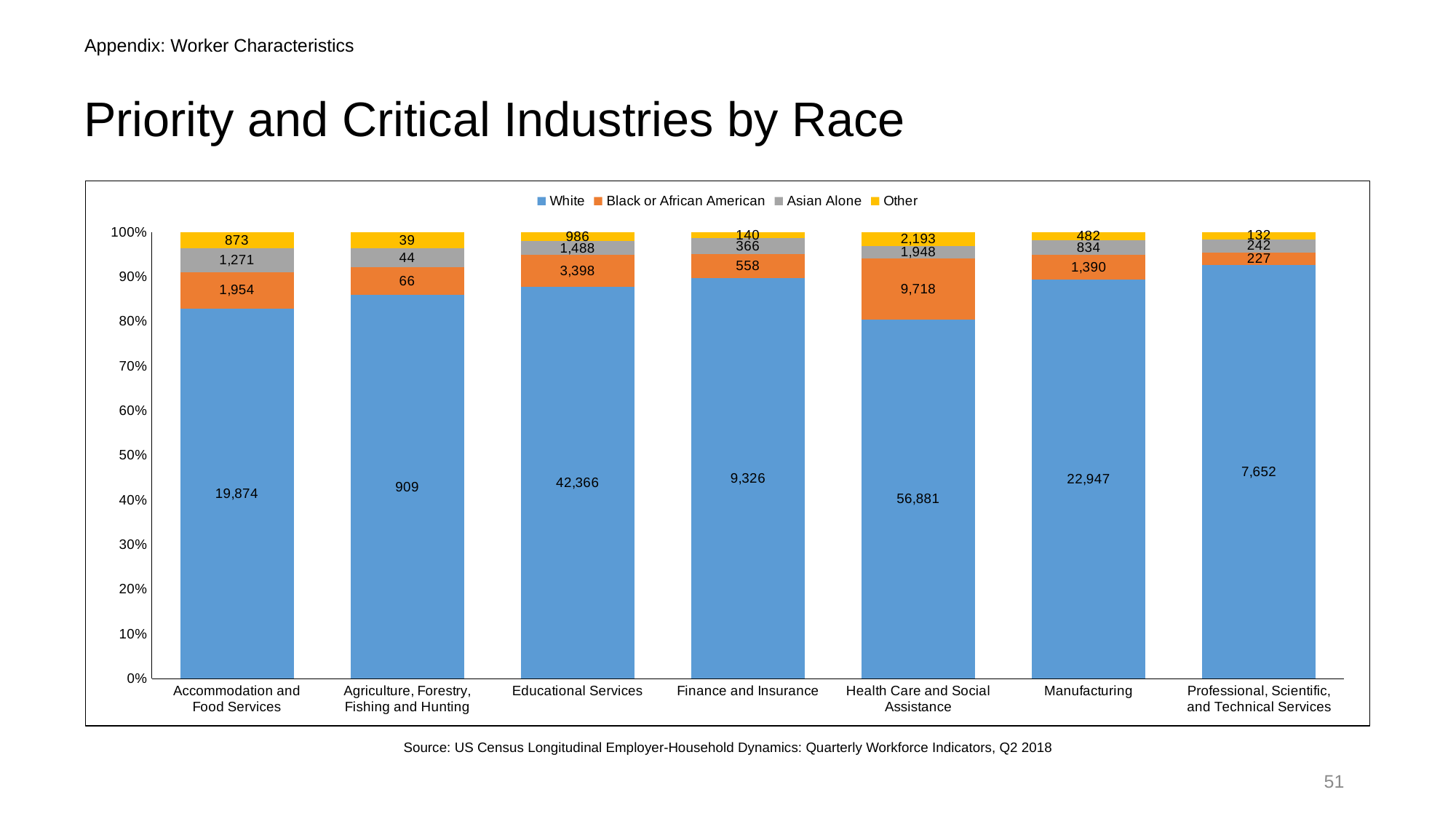
Which industry has the highest number of White workers? Health Care and Social Assistance What is the difference between the Black or African American values for Health Care and Social Assistance and Educational Services? 6,320 What is the total of all four race groups for Accommodation and Food Services? 23,972 How many White workers are shown for Educational Services? 42,366 What is the value for Black or African American workers in Health Care and Social Assistance? 9,718 How many series does the legend list? 4 Which industry has the lowest number of White workers? Agriculture, Forestry, Fishing and Hunting What is the Other value for Agriculture, Forestry, Fishing and Hunting? 39 What is the Asian Alone value for Manufacturing? 834 What type of chart is shown on the slide? Stacked bar chart Which is larger for Professional, Scientific, and Technical Services: the Asian Alone value or the Black or African American value? Asian Alone How many industries are shown on the x axis? 7